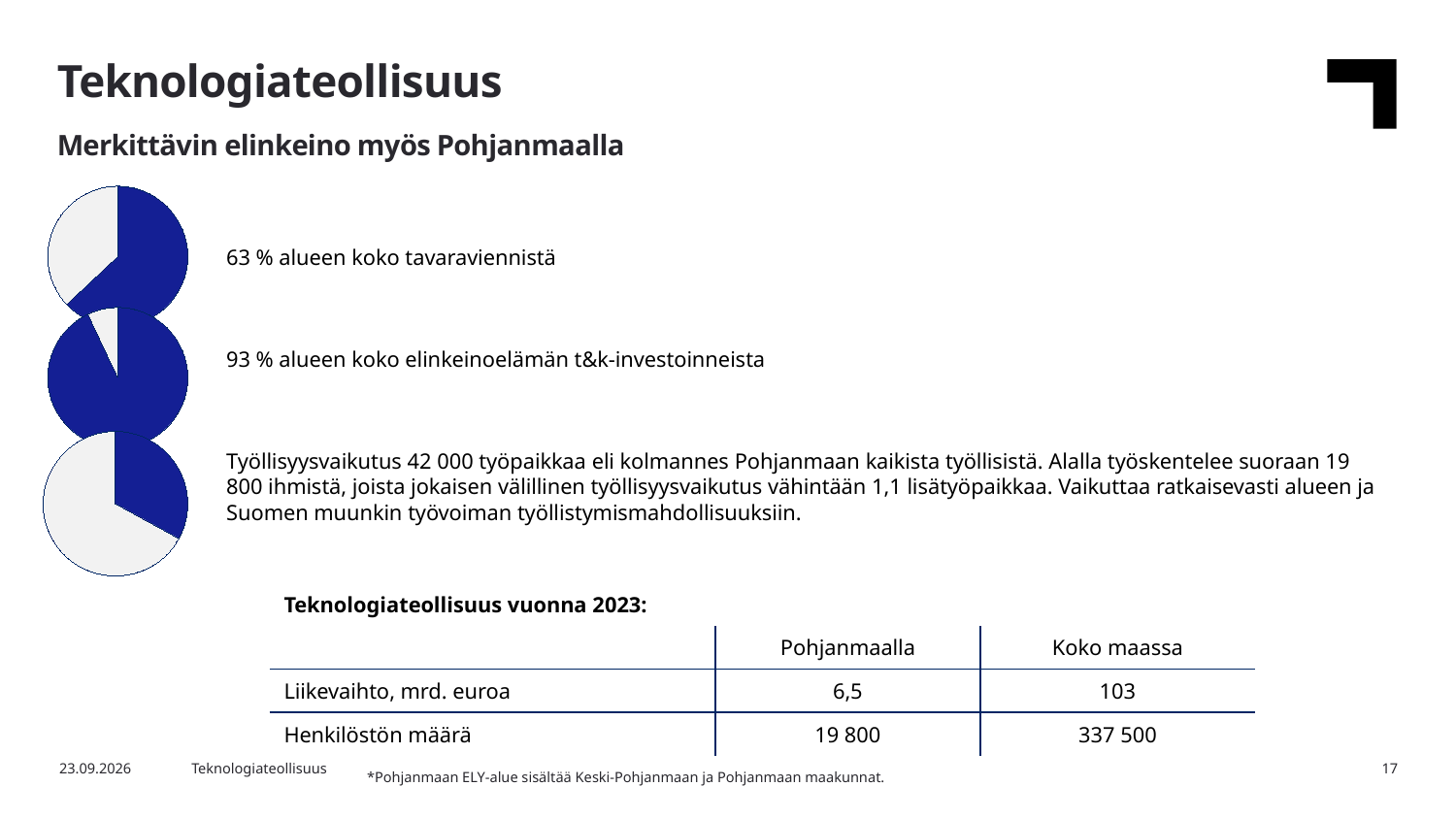
Of the three pie charts, which one has the smallest highlighted slice? the bottom one Of the three pie charts, which one has the largest highlighted slice? the middle one What colour is the highlighted slice in each pie chart? dark blue According to the text beside the middle pie chart, what share of the region's business R&D investments does the highlighted slice represent? 93 % How many slices does each pie chart have? 2 How many pie charts are on the slide? 3 In the top pie chart, is the highlighted slice more or less than half of the pie? more According to the text beside the top pie chart, what share of the region's total goods exports does the highlighted slice represent? 63 % Which pie chart has the larger highlighted (blue) slice, the top one or the middle one? the middle one What kind of charts are shown on the left side of the slide? pie charts In the bottom pie chart, is the highlighted slice more or less than half of the pie? less